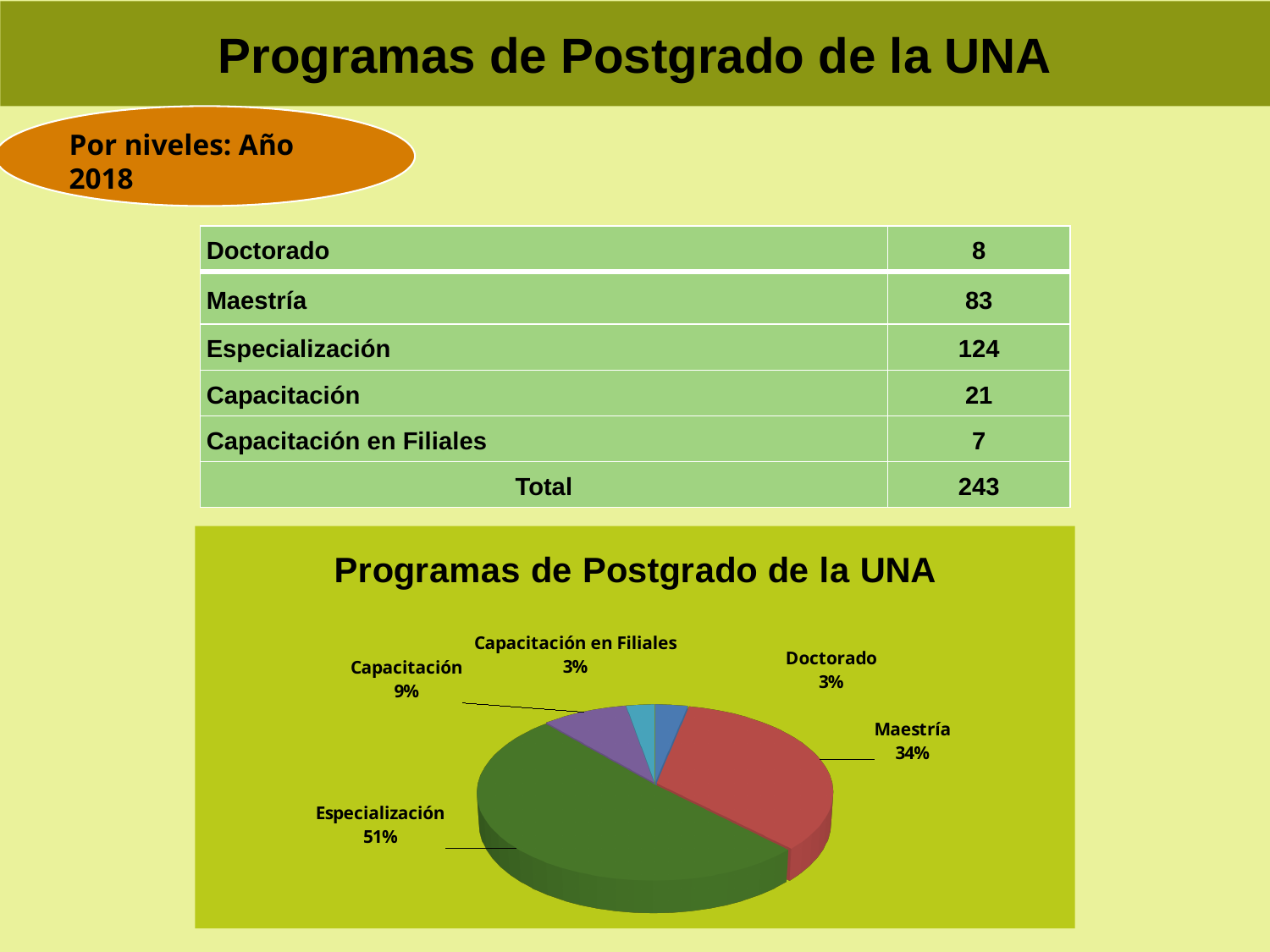
What is the difference in percentage points between the Especialización and Maestría slices? 17 What share of the pie does Capacitación en Filiales represent? 3% What kind of chart is shown on the slide? pie chart Which slice is larger, Maestría or Capacitación? Maestría What share of the pie does Especialización represent? 51% What is the title of the chart? Programas de Postgrado de la UNA What share of the pie does Maestría represent? 34% Which category has the largest slice of the pie? Especialización How many slices does the pie chart have? 5 What colour is the Especialización slice? green